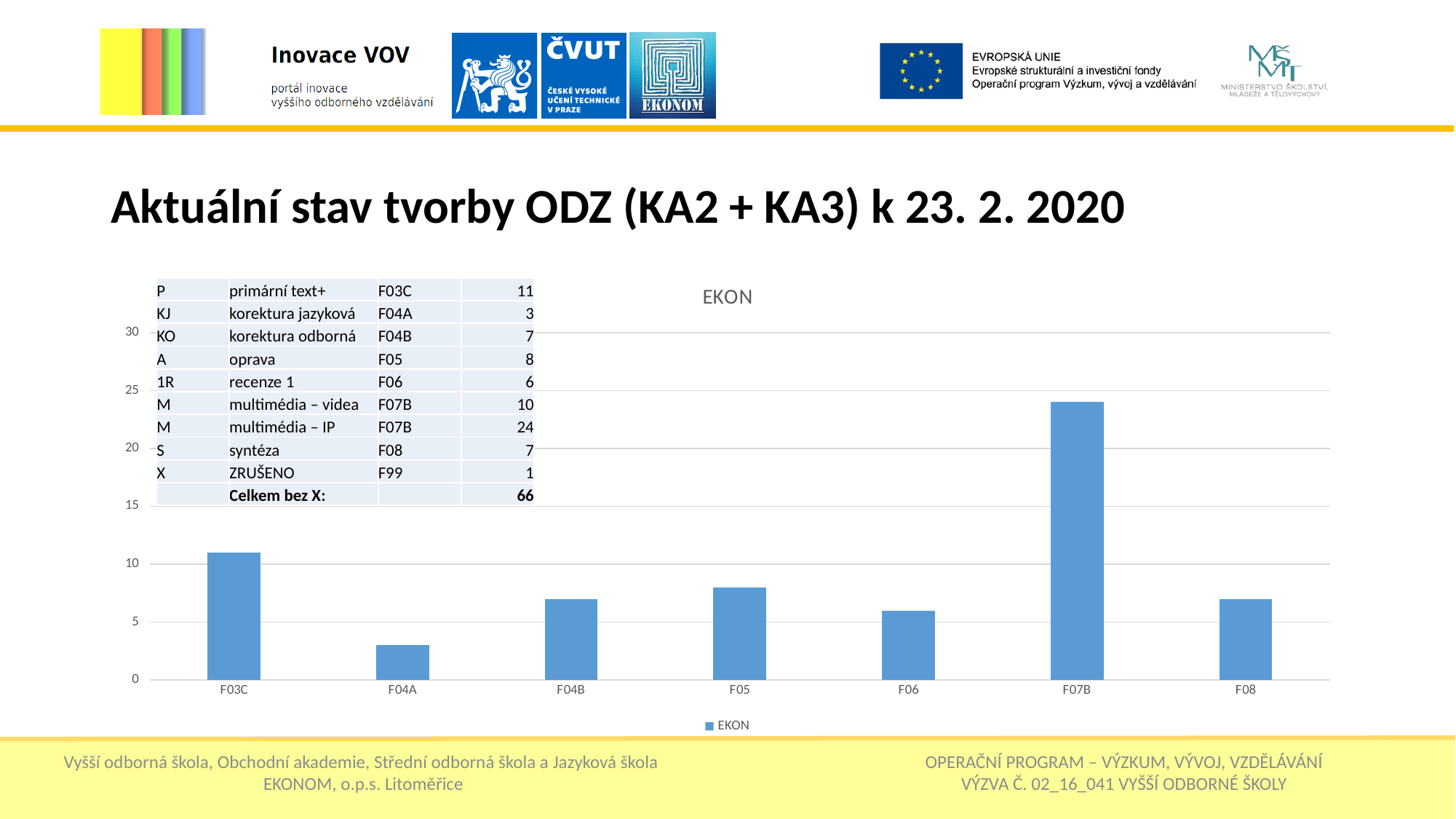
Is the value for F04A greater or less than 5? less What kind of chart is shown on the slide? bar chart Is the value for F07B greater or less than 20? greater Is the value for F03C greater or less than 15? less Which is larger, the value for F03C or the value for F05? F03C What is the title of the chart? EKON How many series does the chart legend list? 1 How many categories are shown on the x axis of the chart? 7 According to the table on the slide, what is the value for F04A? 3 Which category has the lowest bar in the chart? F04A Which category has the highest bar in the chart? F07B